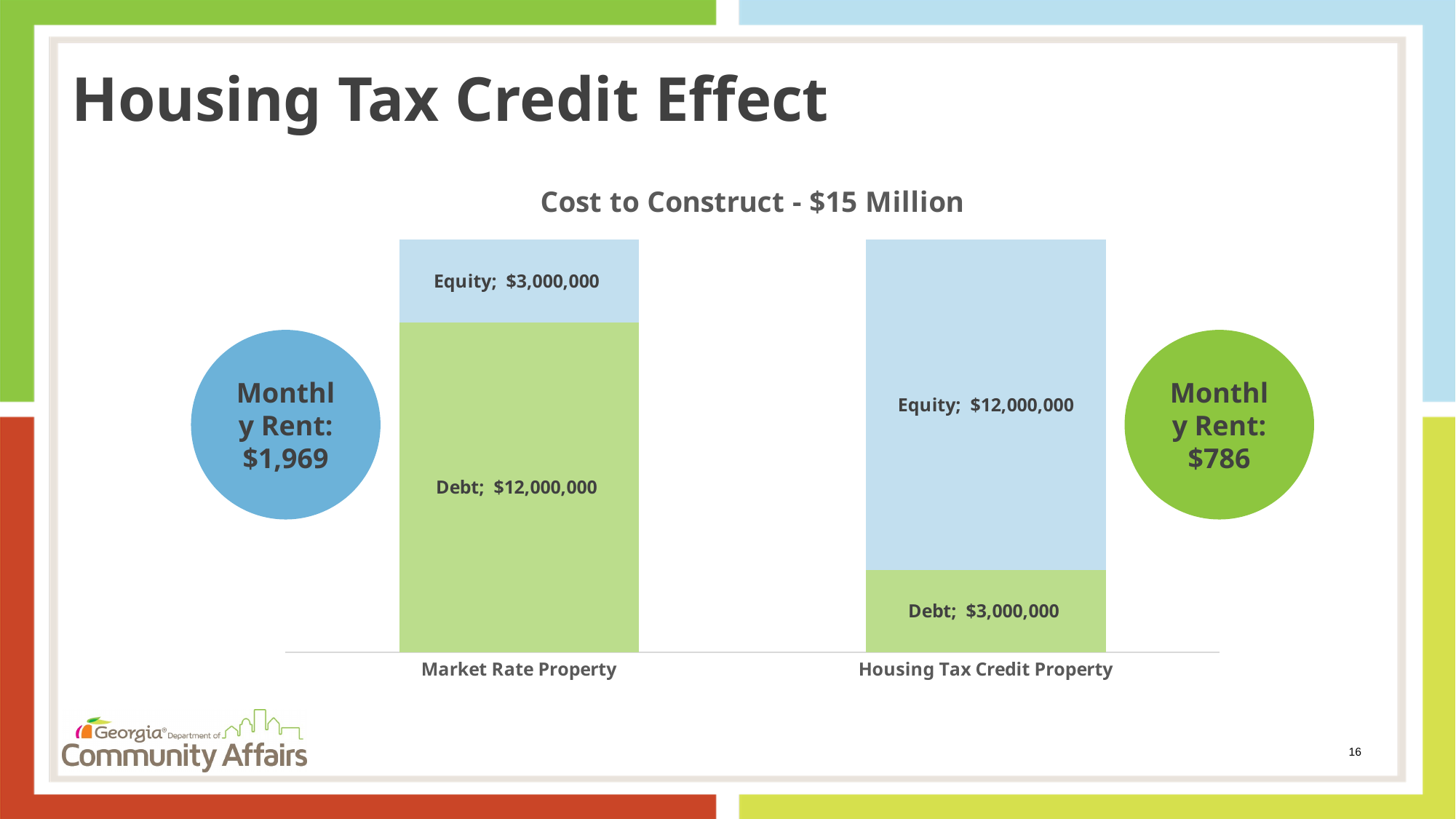
What is the total of the stacked bar for Housing Tax Credit Property? $15,000,000 What is the Equity value for Market Rate Property? $3,000,000 What is the Debt value for Market Rate Property? $12,000,000 Which category has the lowest Debt value? Housing Tax Credit Property What is the difference between the Debt values for Market Rate Property and Housing Tax Credit Property? $9,000,000 What is the total of the stacked bar for Market Rate Property? $15,000,000 What is the title of the chart? Cost to Construct - $15 Million Which category has the higher Equity value, Market Rate Property or Housing Tax Credit Property? Housing Tax Credit Property How many categories are shown on the x axis of the chart? 2 What kind of chart is shown on the slide? Stacked bar chart What is the Equity value for Housing Tax Credit Property? $12,000,000 What is the Debt value for Housing Tax Credit Property? $3,000,000